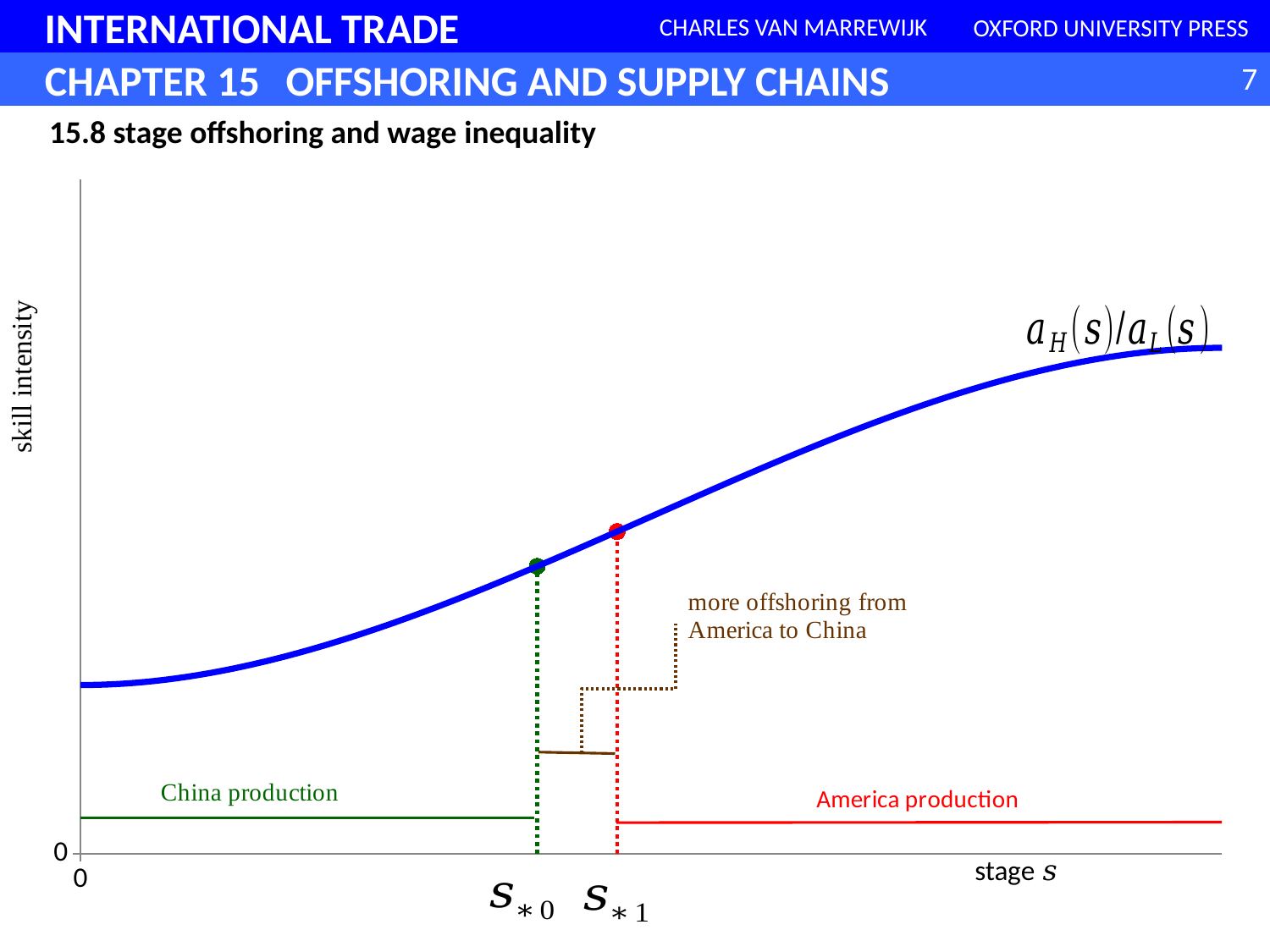
Does the blue curve a_H(s)/a_L(s) rise or fall as stage s increases along the x axis? rise What kind of chart is shown on the slide? line chart How many marked points (dots) are shown on the blue curve? 2 Which production region is labelled to the left of s*0 on the chart? China production Which is larger, the skill intensity at stage s*1 or at stage s*0? s*1 What is the label on the vertical axis of the chart? skill intensity